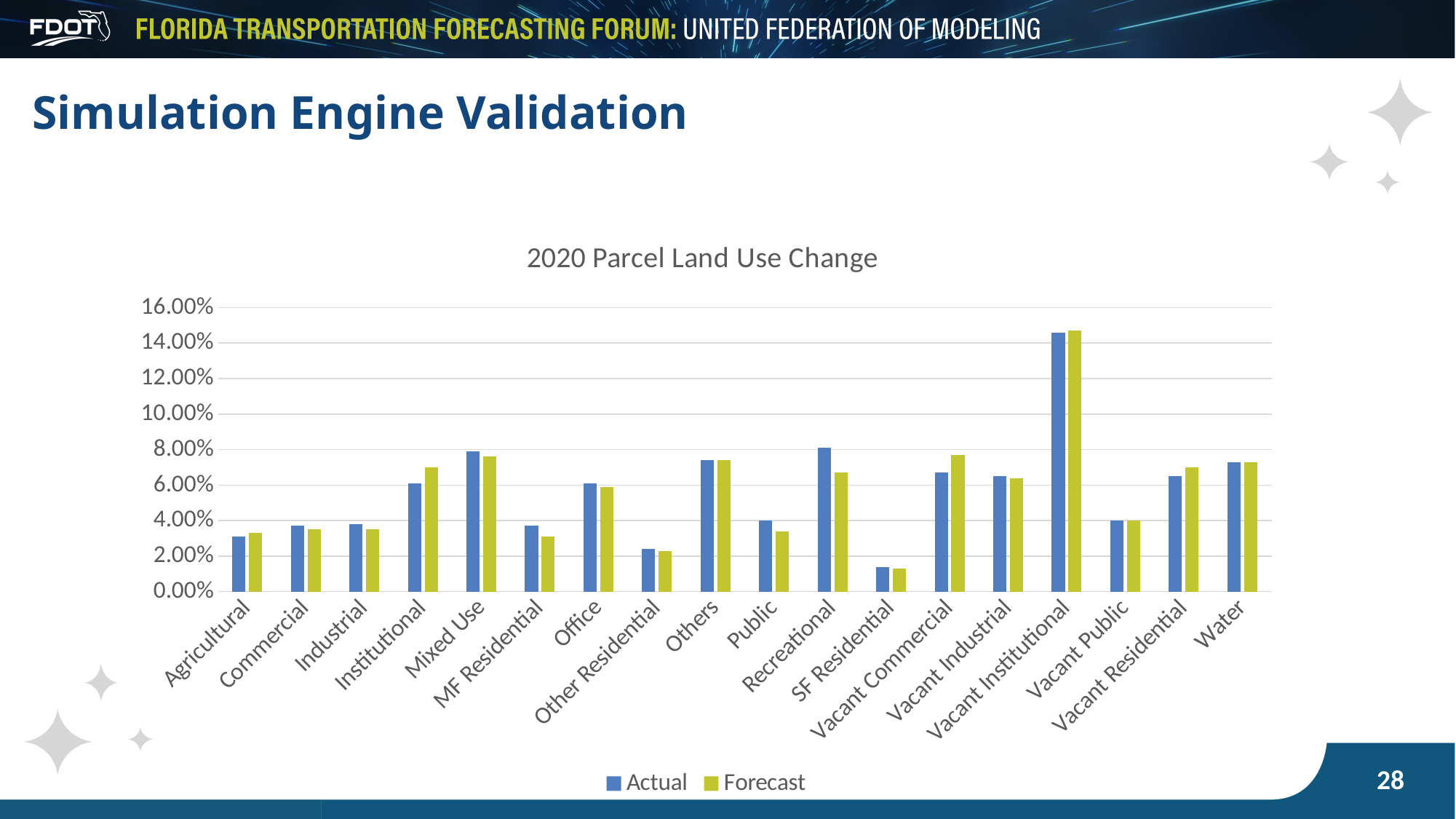
How many land use categories are shown on the x axis? 18 Is the Actual value for Vacant Institutional greater or less than 14.00%? greater For Institutional, which is larger, the Actual or the Forecast value? Forecast What is the title of the chart? 2020 Parcel Land Use Change For Recreational, which is larger, the Actual or the Forecast value? Actual Which series is shown in blue in the legend? Actual Which category has the lowest Forecast value? SF Residential Which category has the highest Actual value? Vacant Institutional Is the Forecast value for Water greater or less than 8.00%? less What type of chart is shown on the slide? bar chart Is the Actual value for SF Residential greater or less than 2.00%? less How many series does the legend list? 2